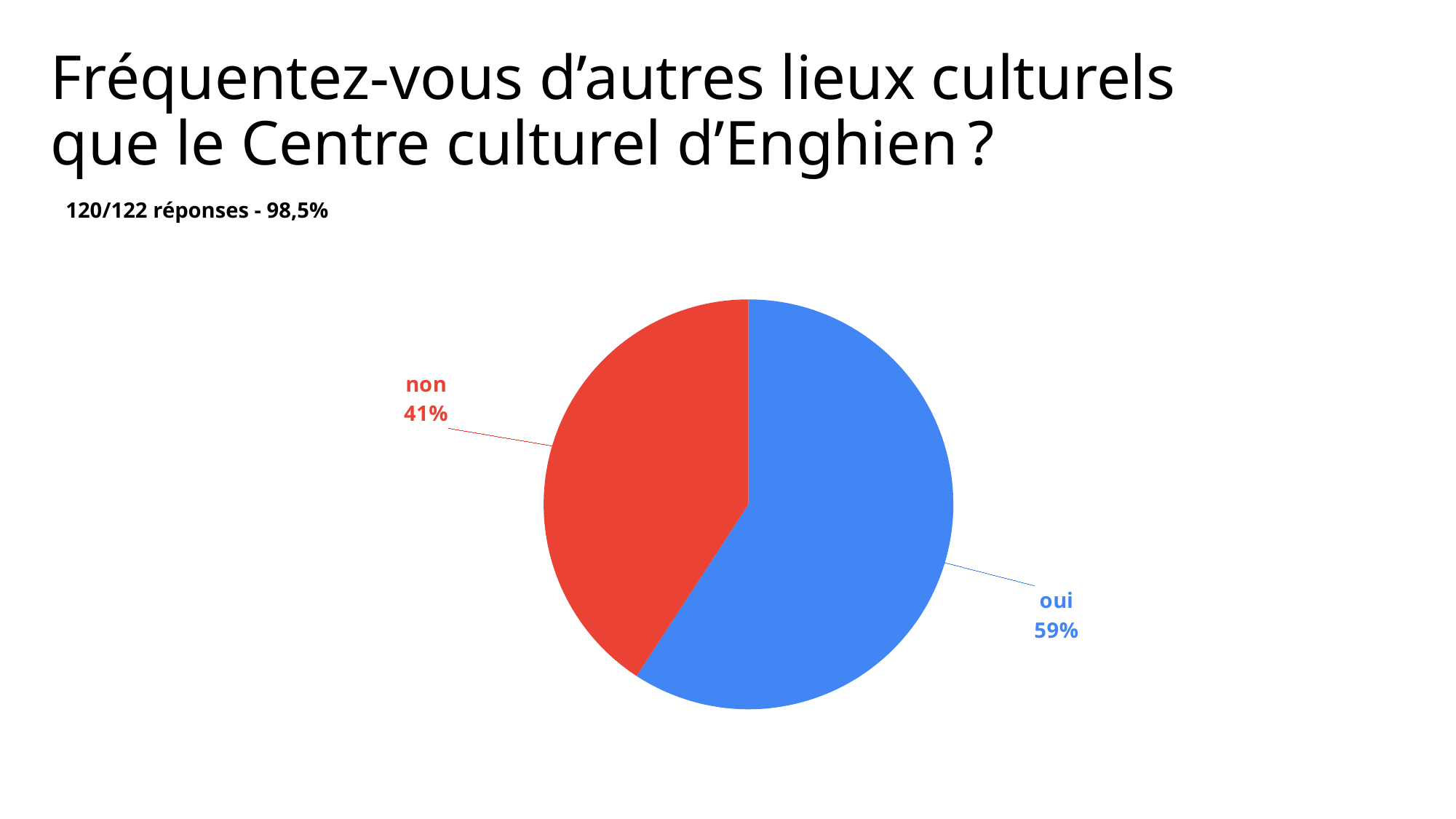
What kind of chart is shown on the slide? pie chart Which slice of the pie is the smallest? non What share of the pie does the "oui" slice represent? 59% How many slices does the pie chart have? 2 What colour is the "non" slice? red Which slice of the pie is the largest? oui How many responses does the slide say the chart is based on? 120/122 réponses - 98,5% What is the difference in percentage points between the "oui" and "non" slices? 18 Which is larger, the "oui" slice or the "non" slice? oui What share of the pie does the "non" slice represent? 41% Is the share for "oui" greater or less than 50%? greater